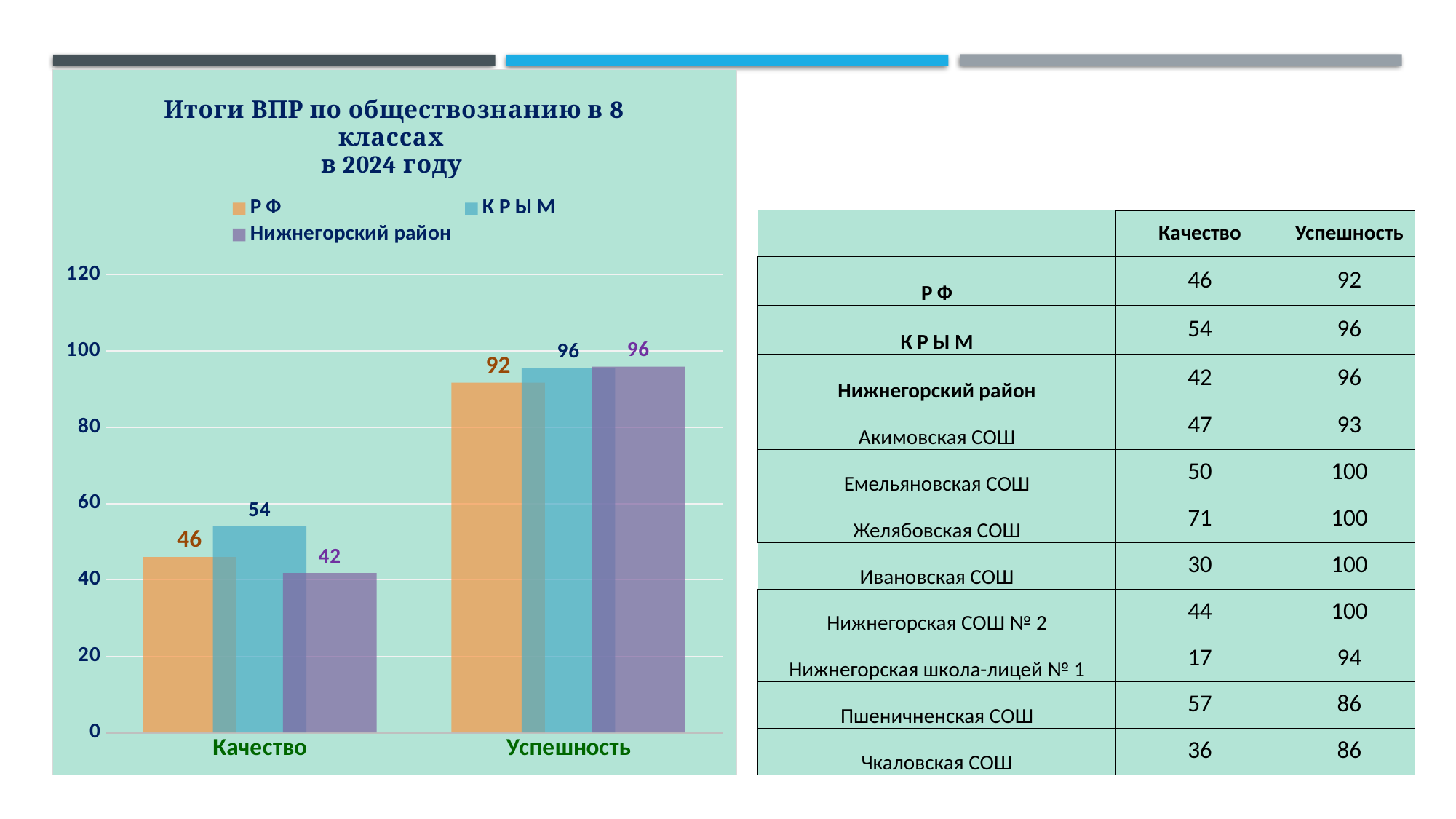
What is the difference between the Успешность and Качество values for Р Ф? 46 What is the value for Р Ф in the Успешность category? 92 What is the value for К Р Ы М in the Качество category? 54 What is the value for Нижнегорский район in the Успешность category? 96 How many series does the legend list? 3 What is the value for Р Ф in the Качество category? 46 What kind of chart is shown on the slide? Bar chart Which is larger: the Р Ф value for Качество or the Нижнегорский район value for Качество? Р Ф Which series has the lowest value in the Качество category? Нижнегорский район What is the difference between the К Р Ы М and Нижнегорский район values in the Качество category? 12 How many categories are shown on the x axis? 2 Which series has the highest value in the Качество category? К Р Ы М